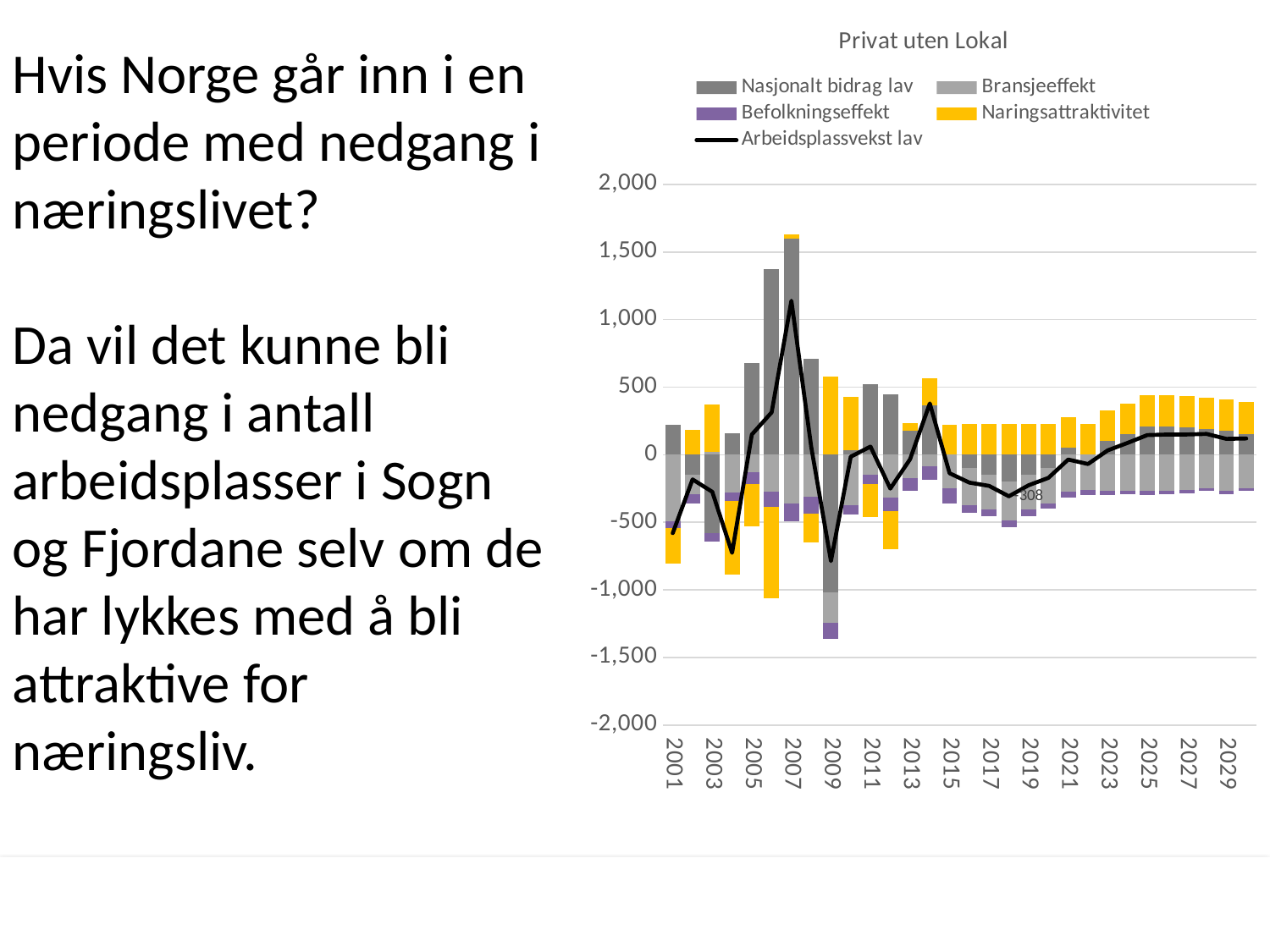
Which series is drawn as a black line? Arbeidsplassvekst lav What is the title of the chart? Privat uten Lokal How many series does the chart legend list? 5 What kind of chart is shown on the slide? Stacked bar chart with a line Does the Arbeidsplassvekst lav line rise or fall between 2021 and 2025? rise Is the Arbeidsplassvekst lav value in 2025 greater or less than 500? less Which year has the tallest positive Nasjonalt bidrag lav bar? 2007 Is the Arbeidsplassvekst lav value in 2007 greater or less than 1,000? greater Is the Nasjonalt bidrag lav bar larger in 2006 or in 2007? 2007 How many year labels are shown on the x axis? 15 In which year does the Arbeidsplassvekst lav line reach its highest value? 2007 Is the Arbeidsplassvekst lav value in 2009 greater or less than -500? less